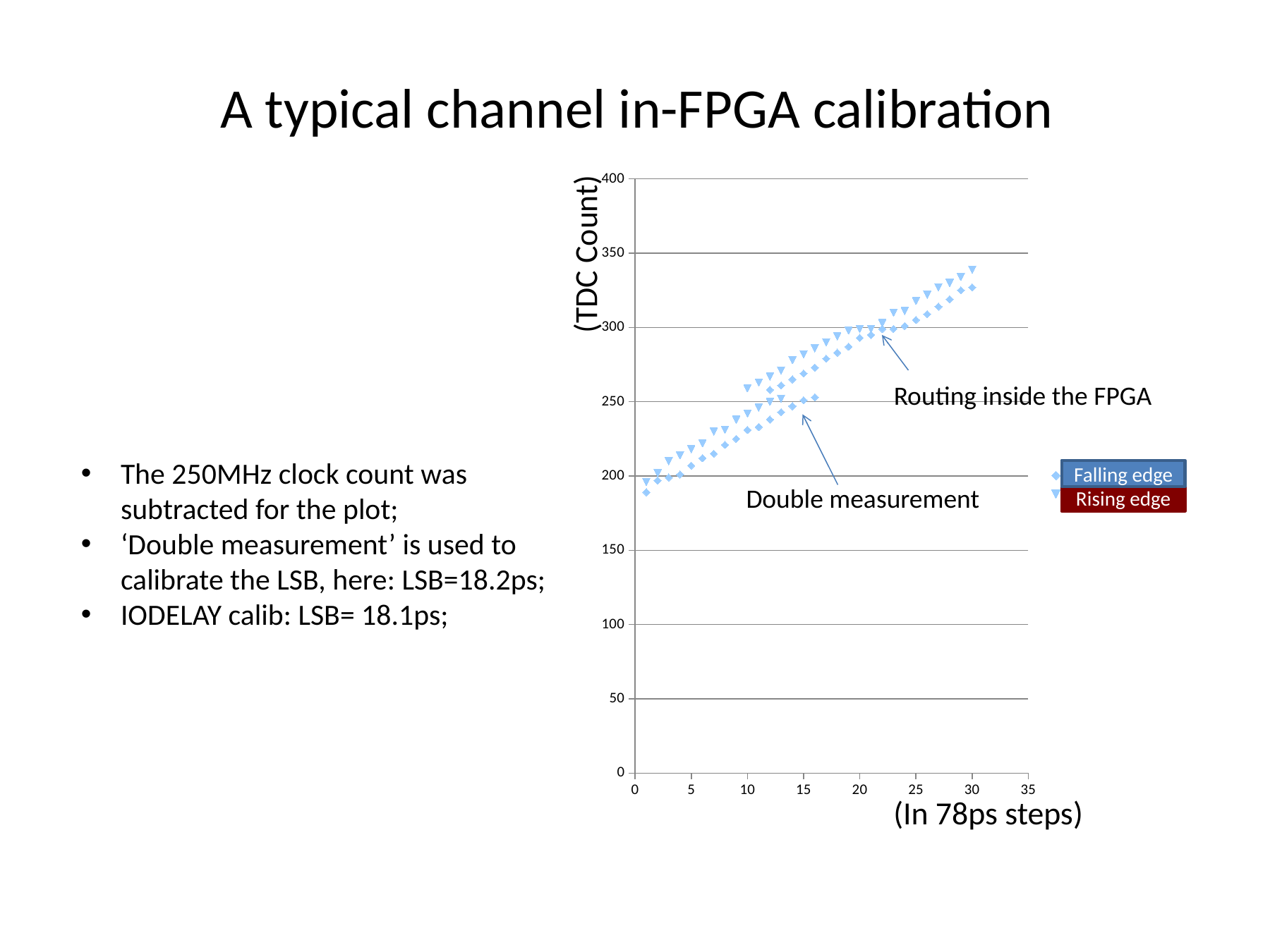
At x = 30, which series has the higher TDC Count, Rising edge or Falling edge? Rising edge How many series does the chart's legend list? 2 Is the Falling edge value at x = 1 greater or less than 200? less Do the TDC Count values rise or fall as the x-axis value increases? rise What kind of chart is shown on the slide? scatter chart What is the highest tick value shown on the chart's vertical axis? 400 What is the label on the chart's vertical axis? (TDC Count) What are the two series named in the chart's legend? Falling edge and Rising edge Is the Rising edge value at x = 30 greater or less than 300? greater Is the Falling edge value at x = 30 greater or less than 300? greater